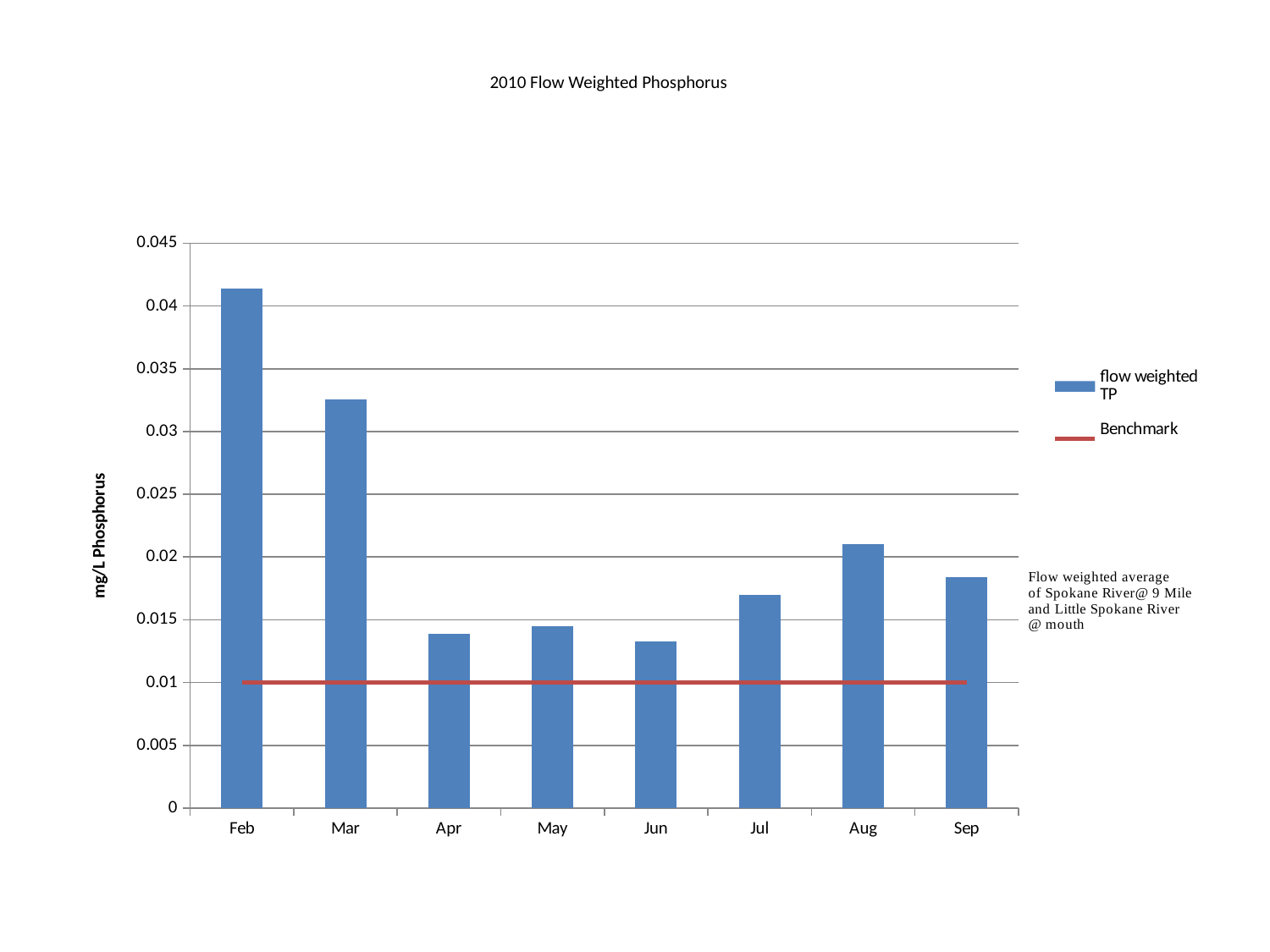
Which is larger, the flow weighted TP value for Feb or for Mar? Feb How many series does the legend list? 2 Is the flow weighted TP value for Aug greater or less than 0.02? greater Is the flow weighted TP value for Feb greater or less than 0.04? greater Which month has the highest flow weighted TP value? Feb Do the flow weighted TP values rise or fall from Feb to Jun? fall Is the flow weighted TP value for Mar greater or less than 0.03? greater How many months are shown on the x axis? 8 What is the title of the chart? 2010 Flow Weighted Phosphorus What kind of chart is shown on the slide? bar chart Which is larger, the flow weighted TP value for Jul or for Aug? Aug